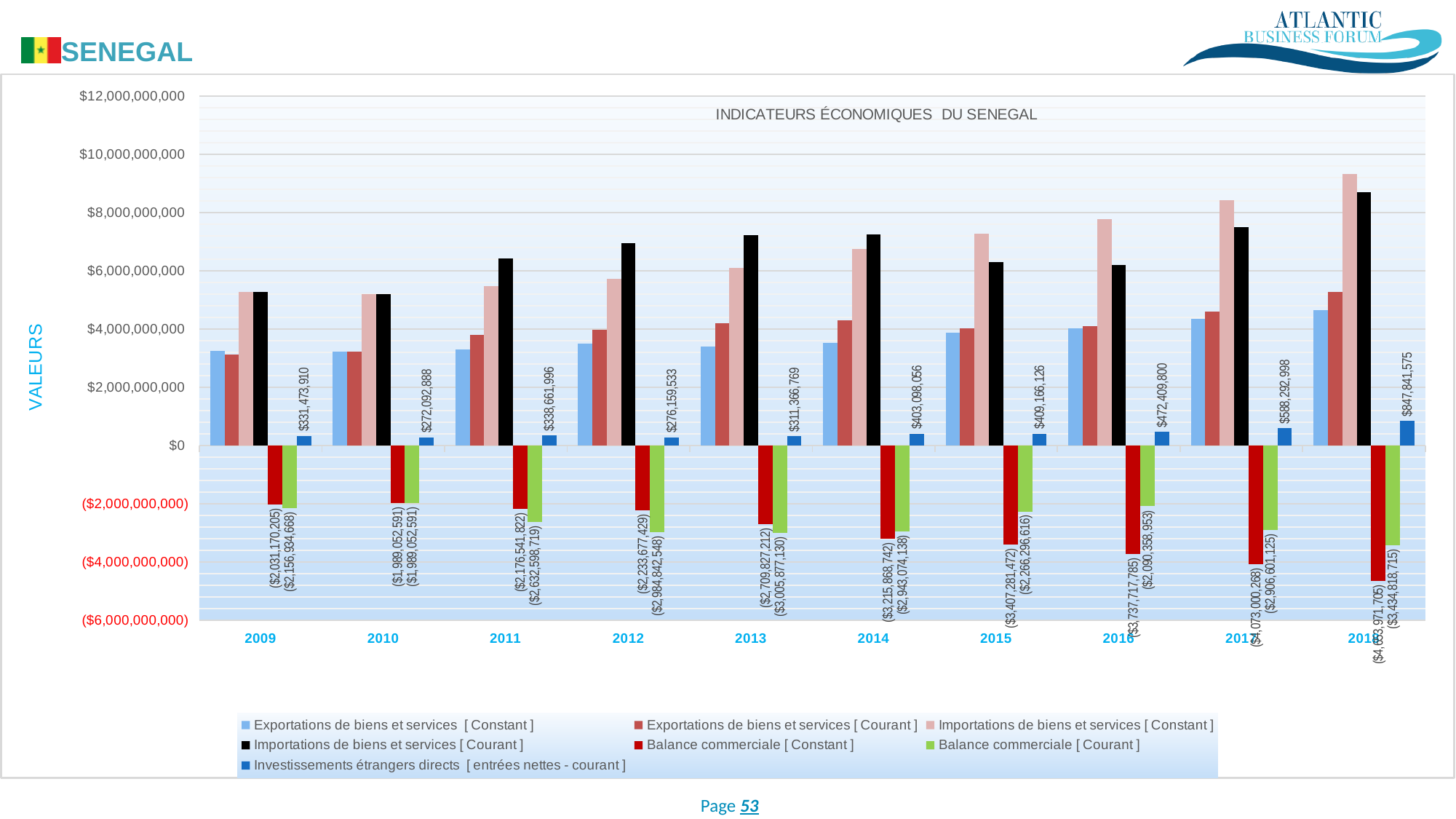
What is the value of Investissements étrangers directs in 2010? $272,092,888 In which year is Investissements étrangers directs the lowest? 2010 What is the value of Balance commerciale [Constant] in 2018? ($4,653,971,705) What kind of chart is shown on the slide? bar chart What is the value of Investissements étrangers directs in 2018? $847,841,575 What is the title of the chart? INDICATEURS ÉCONOMIQUES DU SENEGAL How many years are shown on the x axis of the chart? 10 How many series does the chart legend list? 7 In which year is Investissements étrangers directs the highest? 2018 Does Investissements étrangers directs rise or fall from 2013 to 2018? rise By how much did Investissements étrangers directs increase from 2017 to 2018? $259,548,577 Is the value of Importations de biens et services [Courant] in 2018 greater or less than $8,000,000,000? greater